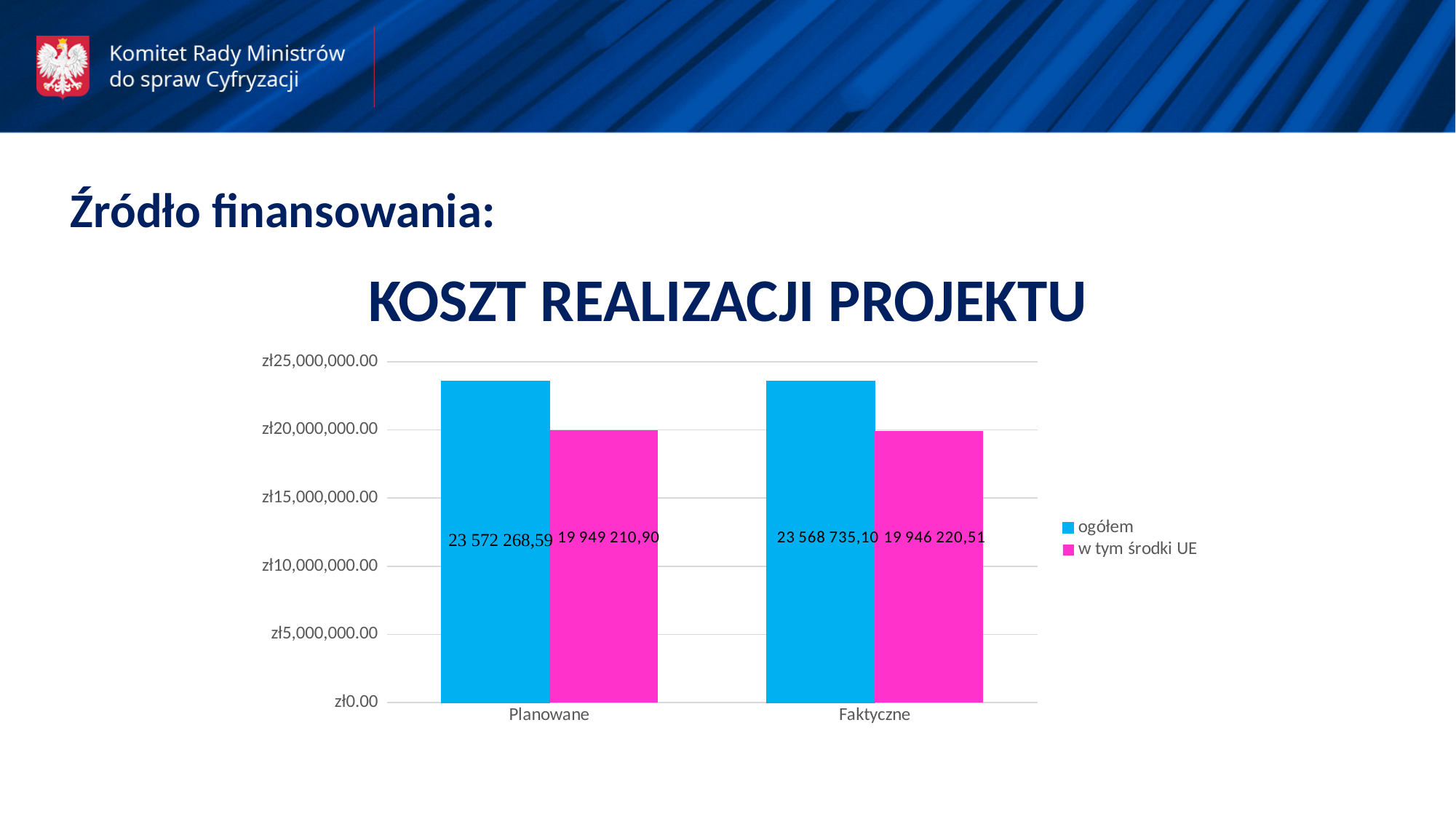
What is the value of 'w tym środki UE' for Faktyczne? 19 946 220,51 Is the value of 'ogółem' for Faktyczne greater or less than zł20,000,000.00? greater What is the value of 'w tym środki UE' for Planowane? 19 949 210,90 What type of chart is shown on the slide? bar chart What is the title of the chart? KOSZT REALIZACJI PROJEKTU What is the value of 'ogółem' for Planowane? 23 572 268,59 For Faktyczne, which is larger: 'ogółem' or 'w tym środki UE'? ogółem What is the difference between the 'ogółem' values for Planowane and Faktyczne? 3 533,49 How many categories are shown on the x axis? 2 What is the difference between 'ogółem' and 'w tym środki UE' for Planowane? 3 623 057,69 What is the value of 'ogółem' for Faktyczne? 23 568 735,10 How many series does the legend list? 2